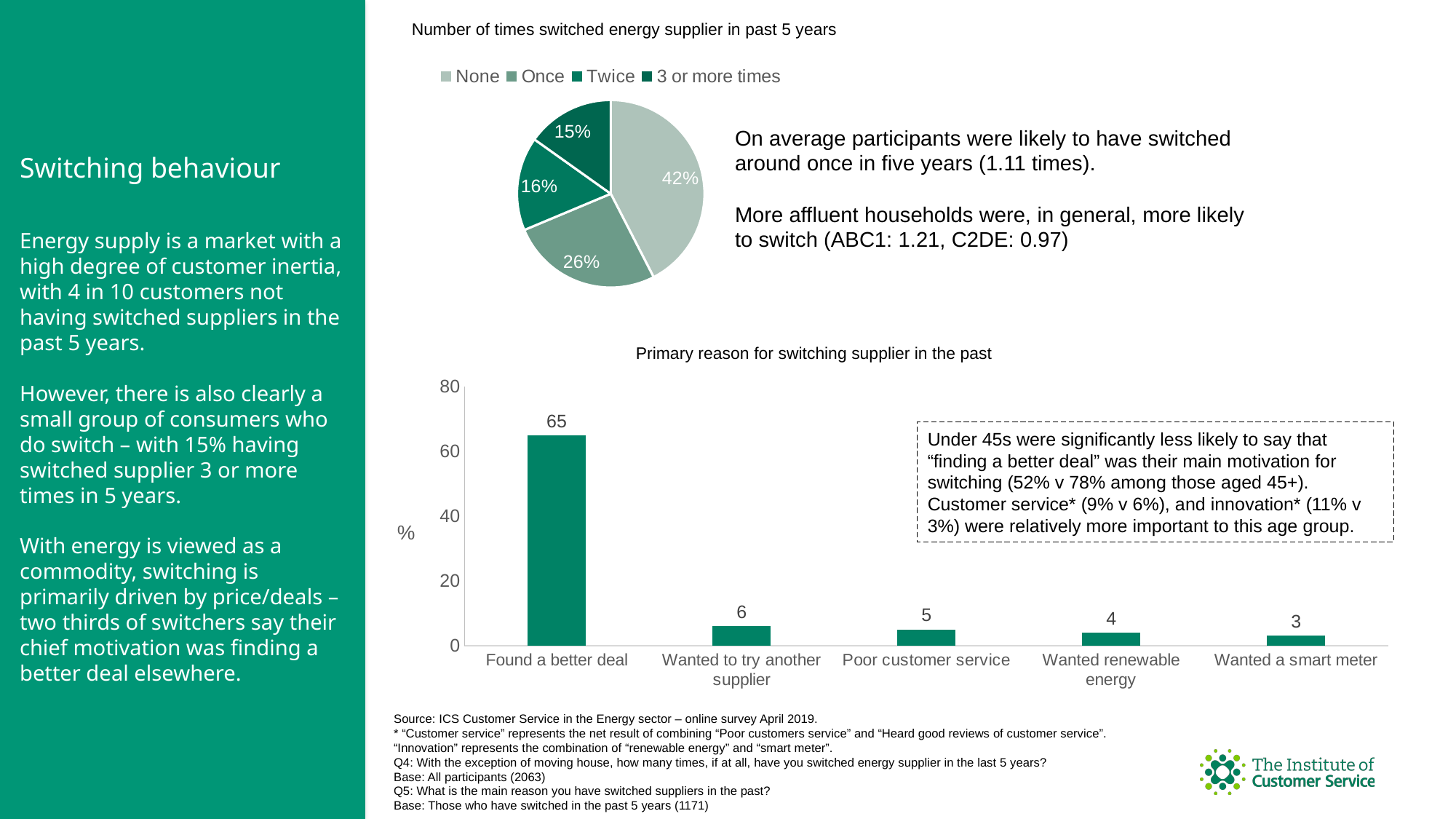
In the bar chart 'Primary reason for switching supplier in the past', what is the value for 'Found a better deal'? 65 What type of chart is 'Primary reason for switching supplier in the past'? Bar chart In the pie chart 'Number of times switched energy supplier in past 5 years', what share of participants had switched 'None' times? 42% In the pie chart 'Number of times switched energy supplier in past 5 years', what share of participants had switched 'Once'? 26% In the pie chart 'Number of times switched energy supplier in past 5 years', what is the difference in percentage points between 'None' and 'Once'? 16 In the pie chart 'Number of times switched energy supplier in past 5 years', which category has the largest slice? None In the bar chart 'Primary reason for switching supplier in the past', which reason has the lowest value? Wanted a smart meter In the bar chart 'Primary reason for switching supplier in the past', what is the difference between 'Found a better deal' and 'Wanted to try another supplier'? 59 In the pie chart 'Number of times switched energy supplier in past 5 years', how many categories does the legend list? 4 In the bar chart 'Primary reason for switching supplier in the past', how many reasons are shown on the x axis? 5 In the bar chart 'Primary reason for switching supplier in the past', what is the value for 'Poor customer service'? 5 In the pie chart 'Number of times switched energy supplier in past 5 years', what share had switched '3 or more times'? 15%